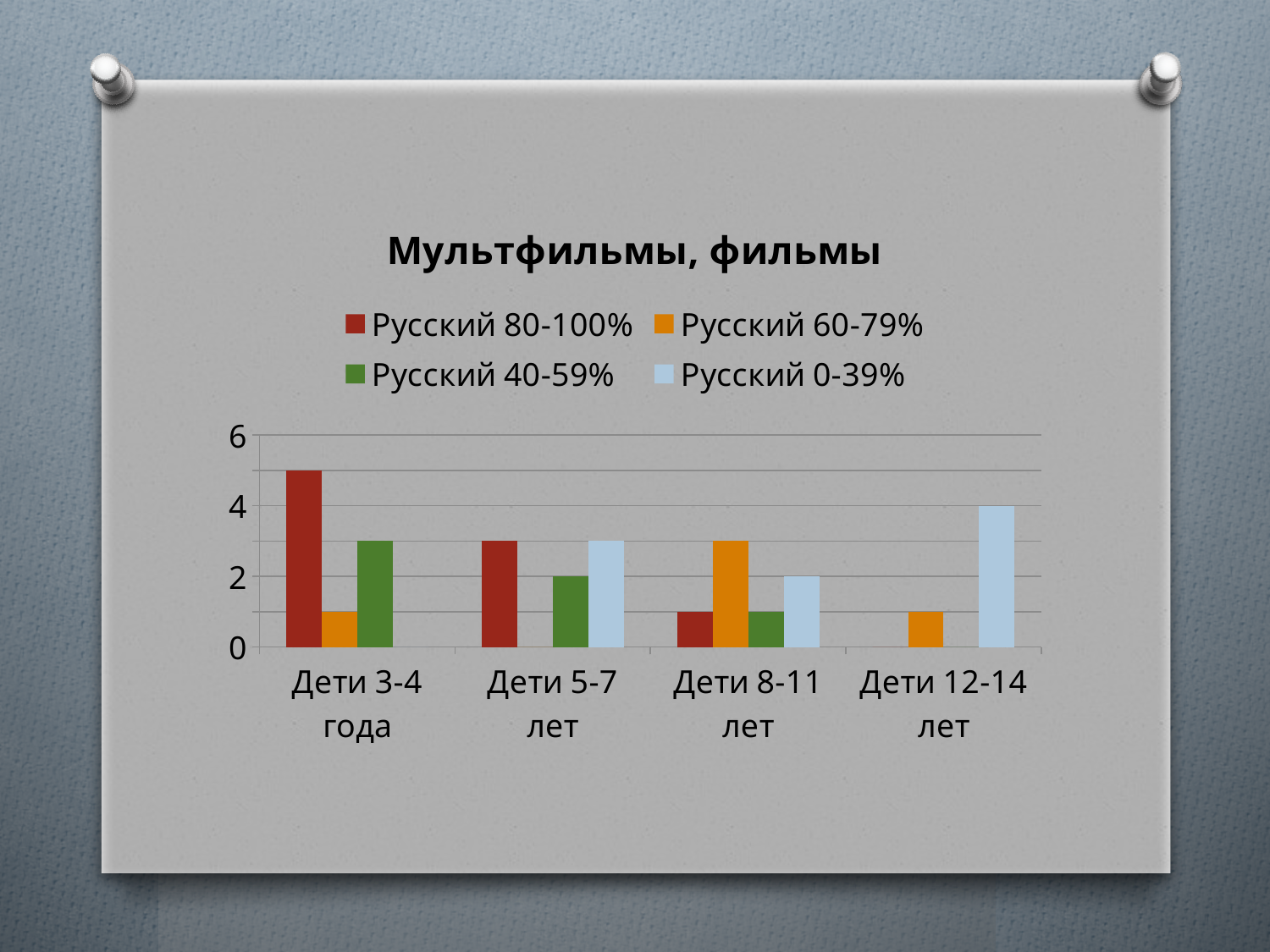
What is the value for Русский 0-39% in the Дети 8-11 лет group? 2 Is the value for Русский 80-100% in the Дети 3-4 года group greater or less than 4? greater How many age-group categories are shown on the x axis? 4 Which series has the highest bar in the Дети 3-4 года group? Русский 80-100% What kind of chart is shown on the slide? bar chart What is the value for Русский 0-39% in the Дети 12-14 лет group? 4 What is the title of the chart? Мультфильмы, фильмы What is the value for Русский 40-59% in the Дети 5-7 лет group? 2 Does the value for Русский 80-100% rise or fall as the age groups go from Дети 3-4 года to Дети 12-14 лет? fall How many series does the legend list? 4 Is the value for Русский 80-100% in the Дети 8-11 лет group greater or less than 2? less Which series has the highest bar in the Дети 12-14 лет group? Русский 0-39%